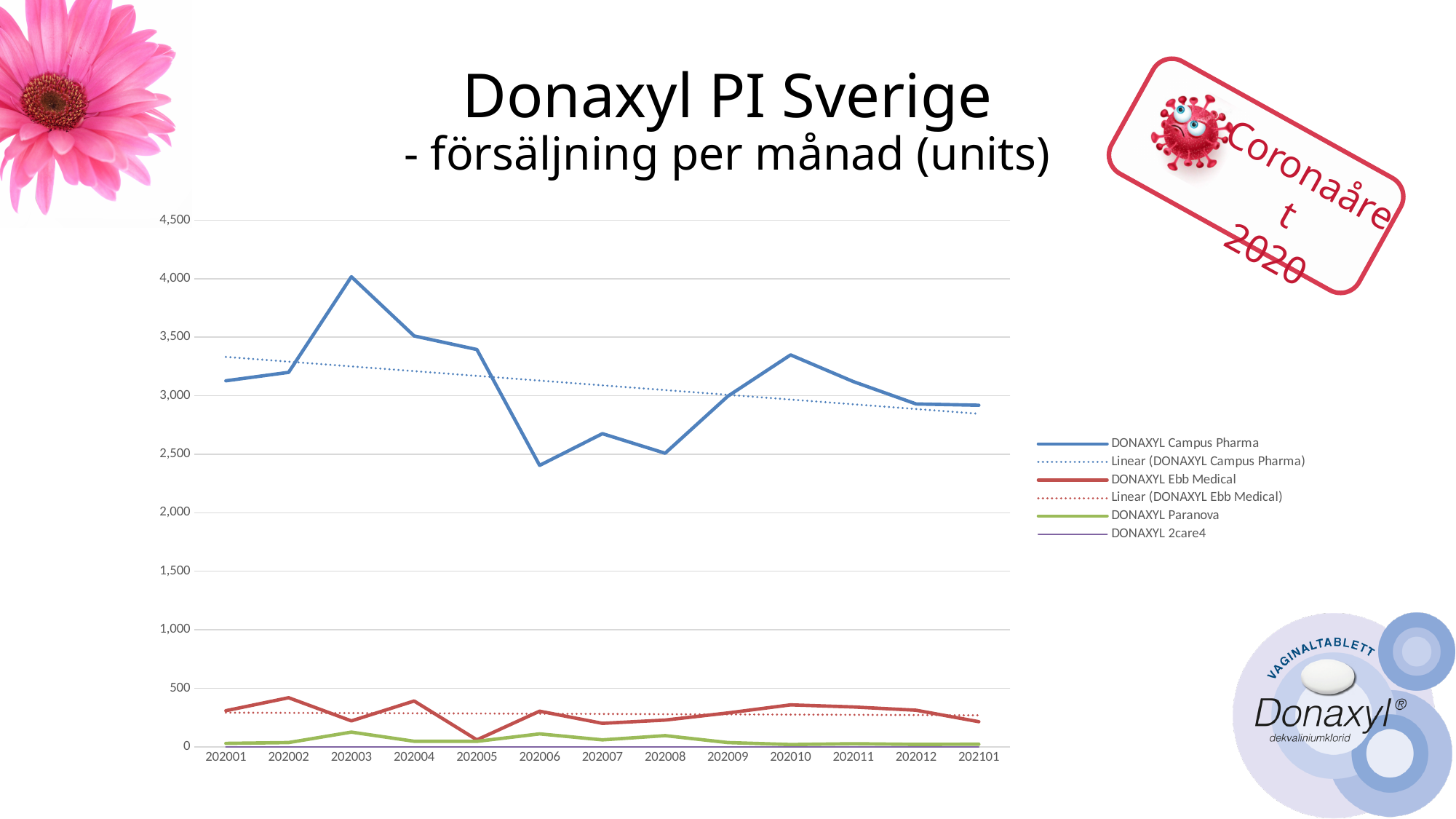
In which month does DONAXYL Campus Pharma reach its lowest value? 202006 How many entries does the chart legend list? 6 Is the value for DONAXYL Campus Pharma in 202003 greater or less than 3,500? greater Is the value for DONAXYL Campus Pharma in 202006 greater or less than 2,500? less How many months are plotted along the x axis? 13 Is the value for DONAXYL Ebb Medical in 202002 greater or less than 500? less In which month does DONAXYL Ebb Medical reach its lowest value? 202005 What kind of chart is shown on the slide? line chart In which month does DONAXYL Campus Pharma reach its highest value? 202003 Does the Linear (DONAXYL Campus Pharma) trendline rise or fall from 202001 to 202101? fall Which is larger in 202010: DONAXYL Ebb Medical or DONAXYL Paranova? DONAXYL Ebb Medical